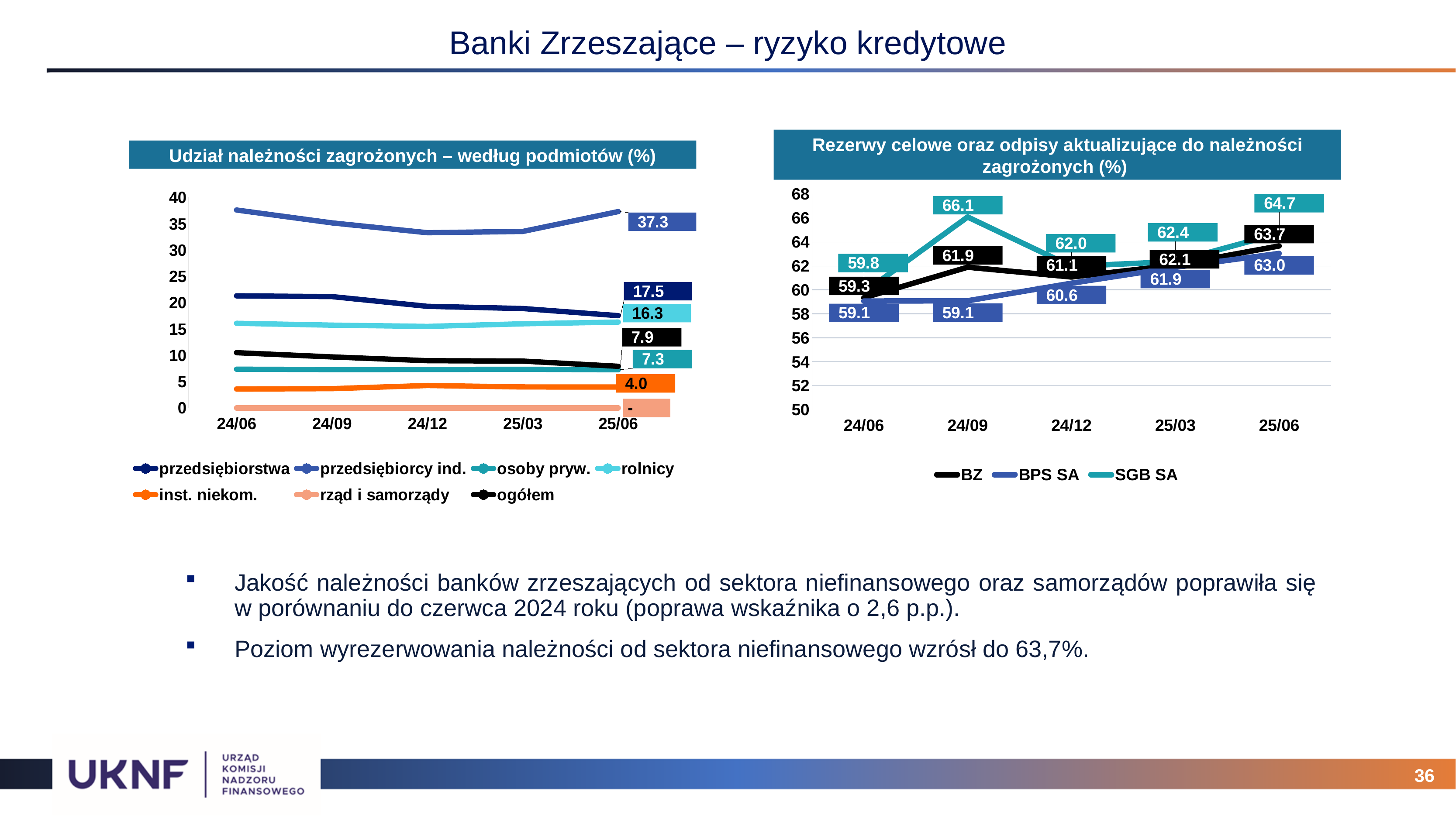
In the chart 'Udział należności zagrożonych – według podmiotów (%)', what is the value for 'ogółem' at 25/06? 7.9 In the chart 'Rezerwy celowe oraz odpisy aktualizujące do należności zagrożonych (%)', does the BPS SA series rise or fall from 24/09 to 25/06? rise In the chart 'Udział należności zagrożonych – według podmiotów (%)', what is the difference between 'przedsiębiorstwa' and 'rolnicy' at 25/06? 1.2 In the chart 'Udział należności zagrożonych – według podmiotów (%)', is the value for 'przedsiębiorcy ind.' at 24/06 greater or less than 35? greater In the chart 'Udział należności zagrożonych – według podmiotów (%)', how many series does the legend list? 7 In the chart 'Rezerwy celowe oraz odpisy aktualizujące do należności zagrożonych (%)', which is larger at 24/12: BZ or SGB SA? SGB SA In the chart 'Rezerwy celowe oraz odpisy aktualizujące do należności zagrożonych (%)', what is the difference between SGB SA and BPS SA at 25/06? 1.7 In the chart 'Udział należności zagrożonych – według podmiotów (%)', which series has the highest value at 25/06? przedsiębiorcy ind. In the chart 'Rezerwy celowe oraz odpisy aktualizujące do należności zagrożonych (%)', at which period does BPS SA reach its lowest value? 24/06 and 24/09 (59.1) In the chart 'Udział należności zagrożonych – według podmiotów (%)', what is the value for 'przedsiębiorcy ind.' at 25/06? 37.3 In the chart 'Rezerwy celowe oraz odpisy aktualizujące do należności zagrożonych (%)', what is the value for SGB SA at 24/09? 66.1 In the chart 'Rezerwy celowe oraz odpisy aktualizujące do należności zagrożonych (%)', what is the value for BZ at 25/06? 63.7